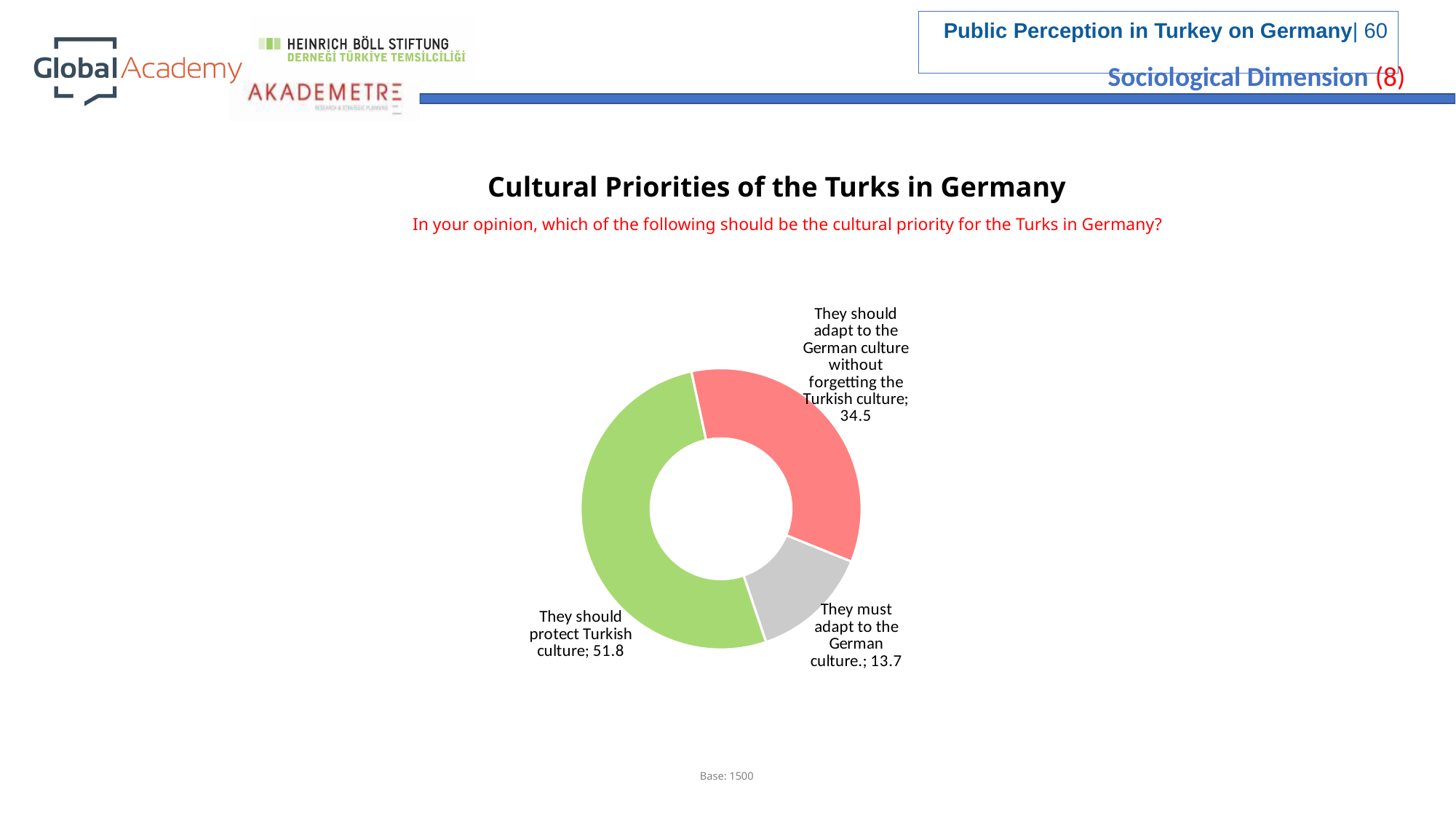
What kind of chart is shown on the slide? Doughnut (pie) chart What colour is the slice for 'They should protect Turkish culture'? Green Which category has the smallest share of the chart? They must adapt to the German culture. What value is shown for 'They should adapt to the German culture without forgetting the Turkish culture'? 34.5 What value is shown for 'They must adapt to the German culture.'? 13.7 What is the title of the chart? Cultural Priorities of the Turks in Germany Which category has the largest share of the chart? They should protect Turkish culture What is the difference between the values for 'They should adapt to the German culture without forgetting the Turkish culture' and 'They must adapt to the German culture.'? 20.8 What value is shown for 'They should protect Turkish culture'? 51.8 Which is larger: the value for 'They should adapt to the German culture without forgetting the Turkish culture' or the value for 'They must adapt to the German culture.'? They should adapt to the German culture without forgetting the Turkish culture How many categories are shown in the chart? 3 What is the difference between the values for 'They should protect Turkish culture' and 'They should adapt to the German culture without forgetting the Turkish culture'? 17.3